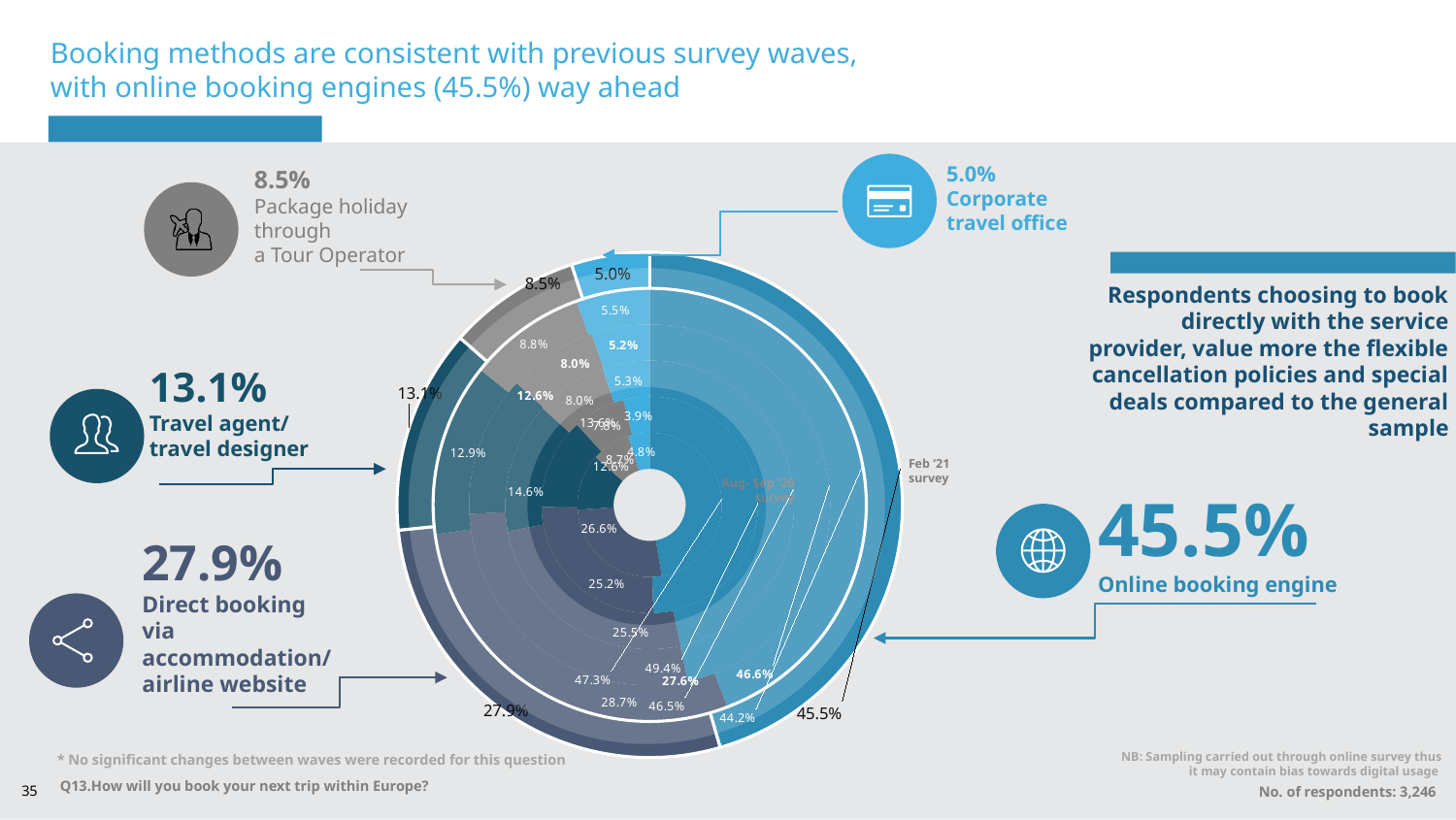
What is the difference between the share for online booking engine and the share for direct booking via accommodation/airline website? 17.6% How many respondents does the slide say took part in the survey? 3,246 What share of respondents plan to book a package holiday through a tour operator? 8.5% Which booking method has the lowest share in the Feb '21 survey? Corporate travel office What share of respondents plan to book through a corporate travel office? 5.0% How many booking methods are shown in the outer ring of the chart? 5 What share of respondents in the Feb '21 survey plan to book via an online booking engine? 45.5% Which is larger: the share for travel agent/travel designer or the share for package holiday through a tour operator? Travel agent/travel designer Which booking method has the highest share in the Feb '21 survey? Online booking engine What kind of chart is used to show the booking methods? Doughnut chart What share of respondents plan to book through a travel agent/travel designer? 13.1% What share of respondents plan to book directly via an accommodation/airline website? 27.9%